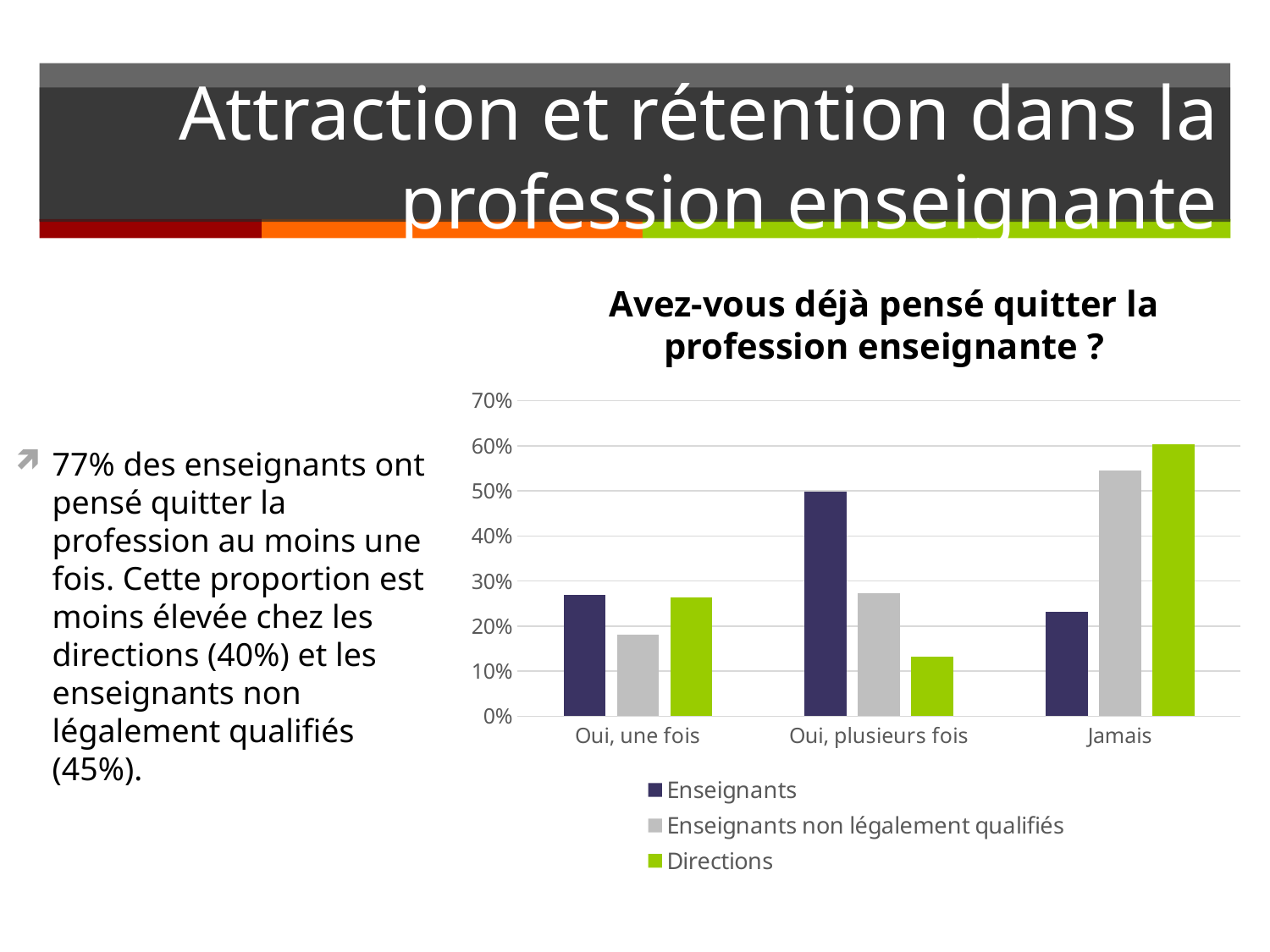
What is the title of the chart? Avez-vous déjà pensé quitter la profession enseignante ? For which category is the Enseignants value highest? Oui, plusieurs fois Is the value for Directions in the Jamais category greater or less than 50%? greater For which category is the Enseignants non légalement qualifiés value highest? Jamais How many categories are shown on the x axis? 3 What kind of chart is shown on the slide? bar chart For which category is the Directions value lowest? Oui, plusieurs fois Is the value for Enseignants in the Oui, plusieurs fois category greater or less than 40%? greater Which series is shown in green in the legend? Directions Is the value for Directions in the Oui, plusieurs fois category greater or less than 20%? less In the Jamais category, which is larger: the Enseignants value or the Directions value? Directions How many series does the legend list? 3